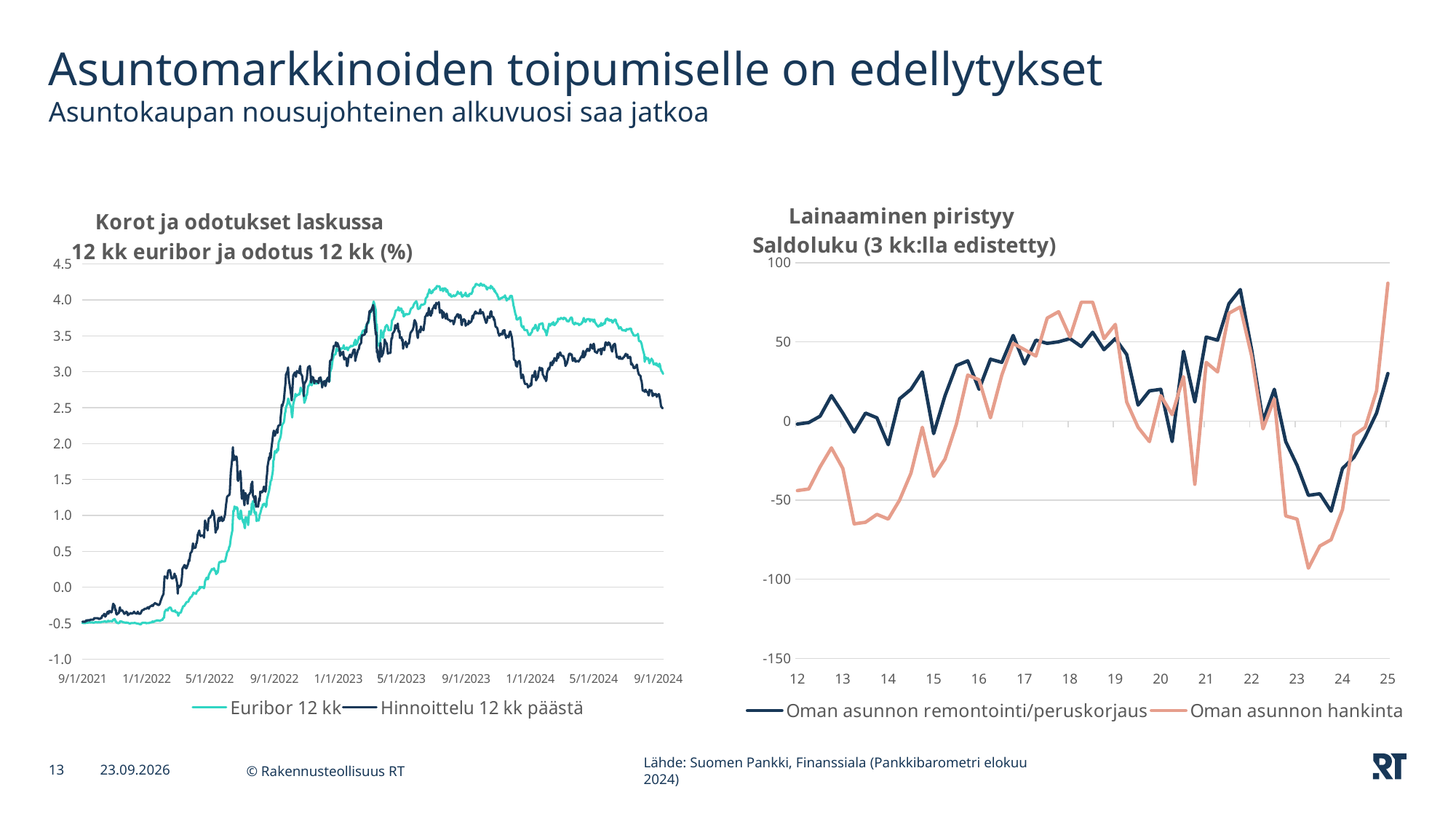
In the left chart "Korot ja odotukset laskussa", what is the subtitle shown under the chart title? 12 kk euribor ja odotus 12 kk (%) In the left chart "Korot ja odotukset laskussa", is the value of Euribor 12 kk at 9/1/2023 greater or less than 4.0? greater In the right chart "Lainaaminen piristyy", which series has the higher value at 25, Oman asunnon hankinta or Oman asunnon remontointi/peruskorjaus? Oman asunnon hankinta In the left chart "Korot ja odotukset laskussa", is the value of Euribor 12 kk at 9/1/2021 greater or less than 0.0? less In the left chart "Korot ja odotukset laskussa", does the Euribor 12 kk series rise or fall between 9/1/2021 and 9/1/2023? rise How many series does the legend of the left chart "Korot ja odotukset laskussa" list? 2 What kind of chart is the left chart titled "Korot ja odotukset laskussa"? line chart In the left chart "Korot ja odotukset laskussa", is the value of Hinnoittelu 12 kk päästä at 9/1/2024 greater or less than 3.0? less In the right chart "Lainaaminen piristyy", which two series are listed in the legend? Oman asunnon remontointi/peruskorjaus; Oman asunnon hankinta How many series does the legend of the right chart "Lainaaminen piristyy" list? 2 What kind of chart is the right chart titled "Lainaaminen piristyy"? line chart